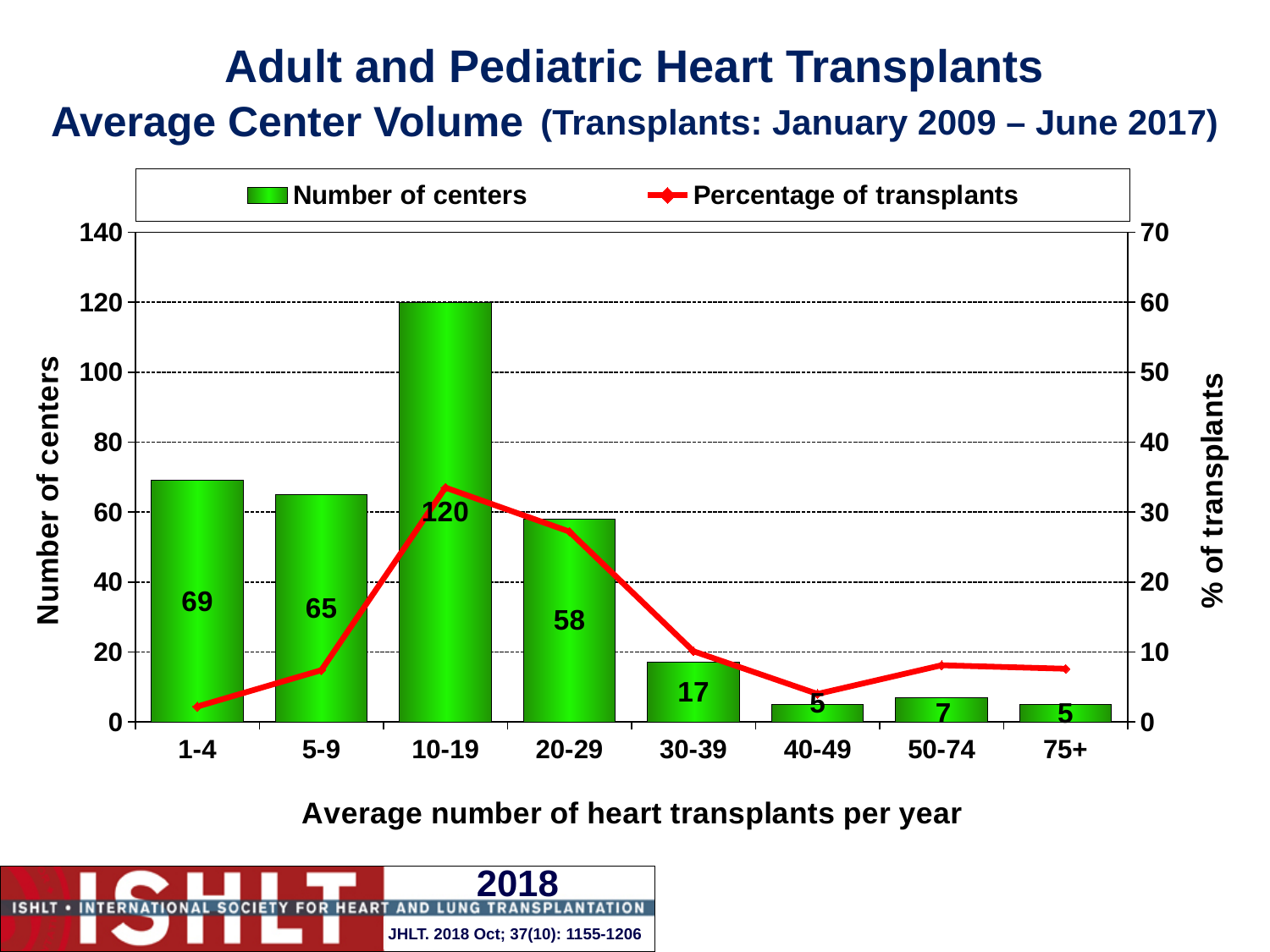
How many series does the legend list? 2 What is the label of the right-hand vertical axis? % of transplants Is the percentage of transplants for the 10-19 category greater or less than 30? greater What is the difference in number of centers between the 10-19 and 20-29 categories? 62 Is the percentage of transplants for the 1-4 category greater or less than 10? less What colour is the Percentage of transplants line? Red How many categories are shown on the x axis? 8 Which category has the highest number of centers? 10-19 Which has more centers, the 1-4 category or the 5-9 category? 1-4 What is the number of centers for the 1-4 category? 69 How many centers are in the 10-19 category? 120 What kind of chart is used for the Number of centers series? Bar chart